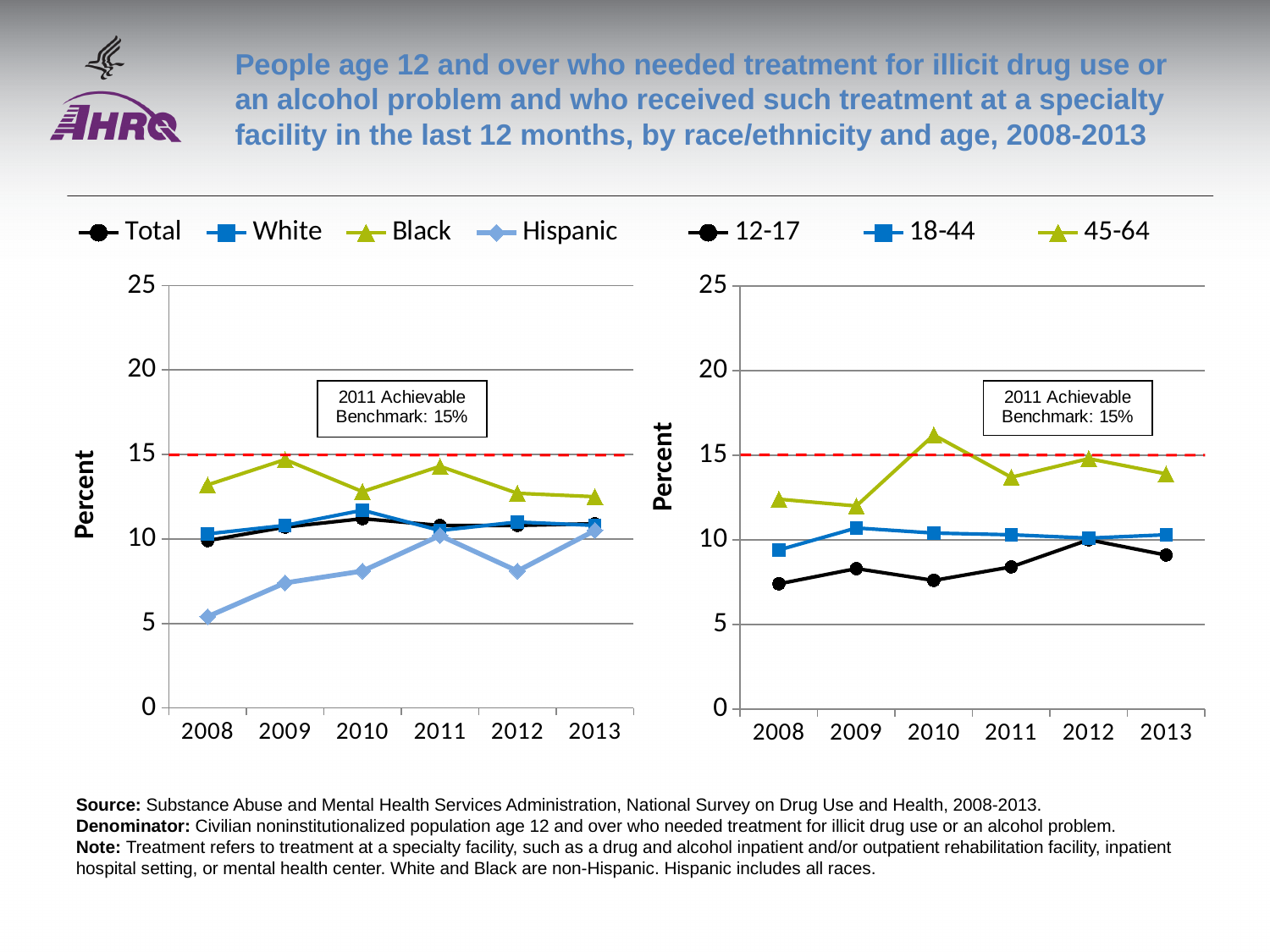
In the left chart (by race/ethnicity), which series has the lowest value in 2008? Hispanic What kind of chart is the left chart (by race/ethnicity)? line chart In the right chart (by age), is the value for 12-17 in 2008 greater or less than 10? less In the left chart (by race/ethnicity), is the value for Hispanic higher in 2013 or in 2008? 2013 In the right chart (by age), which series has the lowest value in 2010? 12-17 How many series does the legend of the right chart (by age) list? 3 How many years are shown on the x axis of the right chart (by age)? 6 What is the 2011 Achievable Benchmark shown on the charts? 15% In the left chart (by race/ethnicity), which series has the highest value in 2008? Black How many series does the legend of the left chart (by race/ethnicity) list? 4 In the right chart (by age), is the value for 45-64 in 2010 greater or less than 15? greater In the left chart (by race/ethnicity), is the value for Hispanic in 2008 greater or less than 10? less